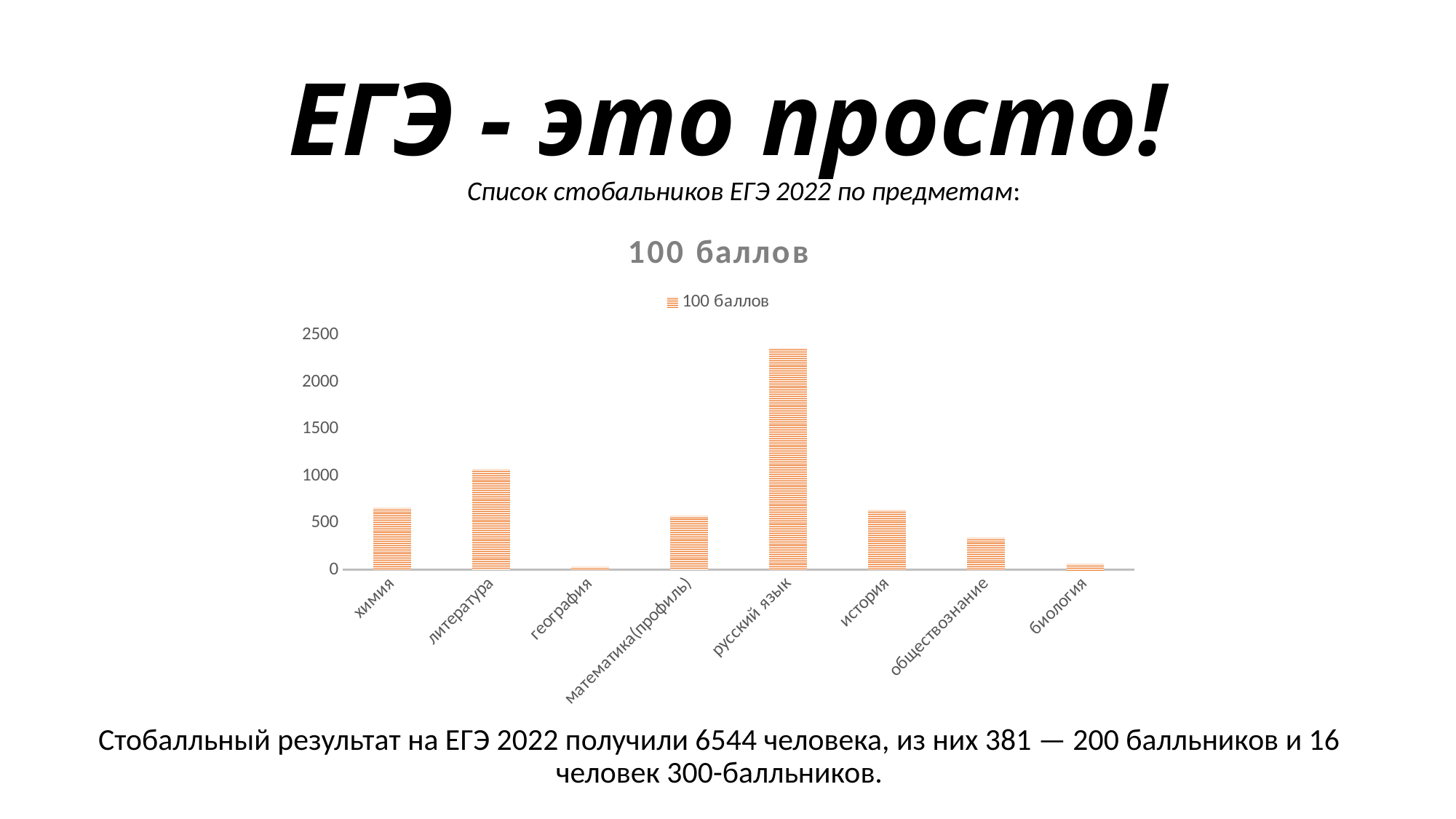
Is the value for география greater or less than 500? less What is the title of the chart? 100 баллов How many series does the chart legend list? 1 Is the value for русский язык greater or less than 2000? greater What kind of chart is shown on the slide? bar chart How many subjects (categories) are shown on the x axis of the chart? 8 Is the value for литература greater or less than 500? greater Which is larger, the value for история or the value for обществознание? история Which is larger, the value for литература or the value for химия? литература Which subject has the highest bar in the chart? русский язык